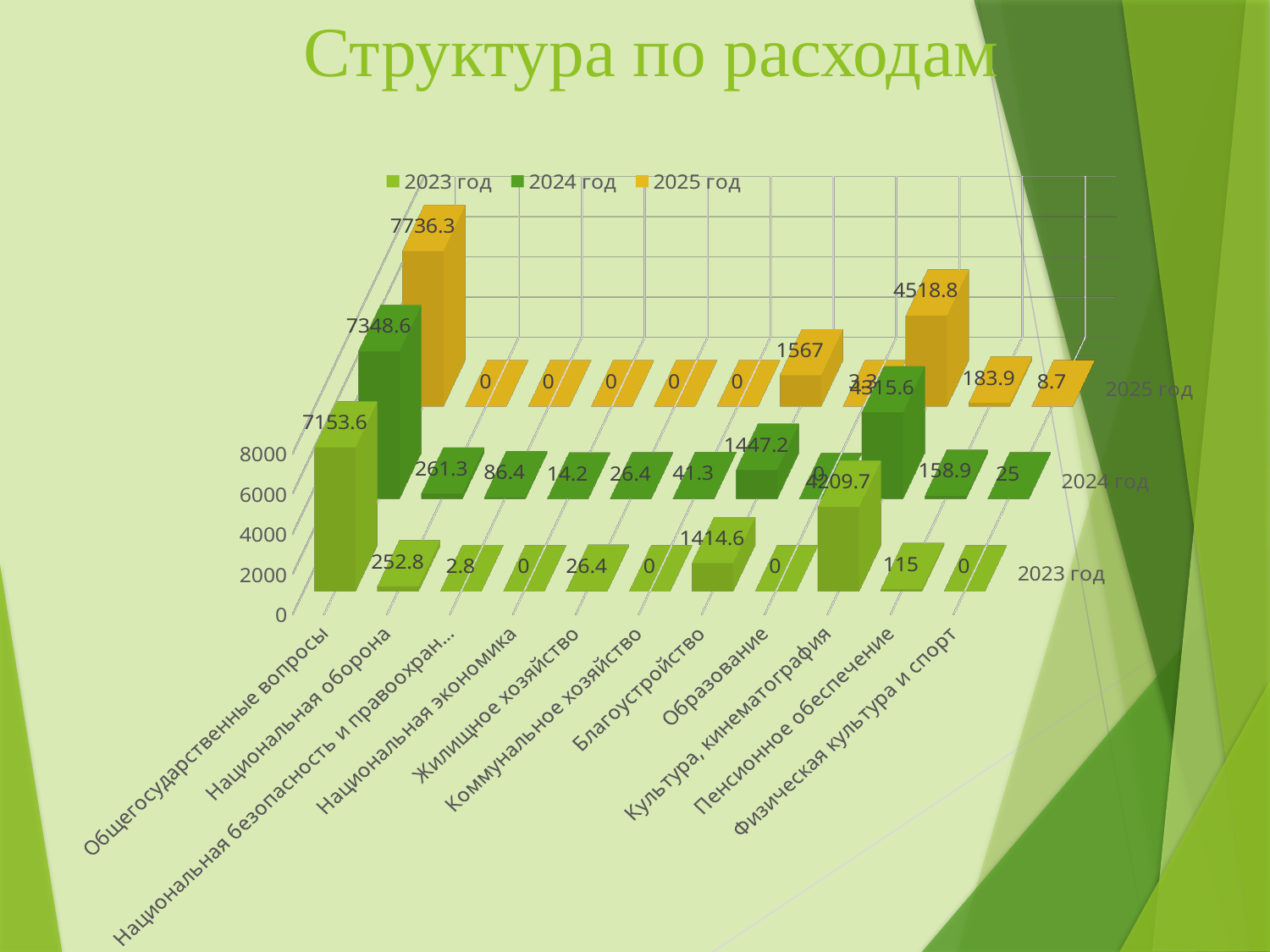
How many categories are shown on the x axis? 11 Does the value for Культура, кинематография rise or fall from 2023 год to 2025 год? Rise What kind of chart is shown on the slide? Bar chart What is the title of the chart? Структура по расходам What is the value for Культура, кинематография in the 2023 год series? 4209.7 What is the value for Общегосударственные вопросы in the 2025 год series? 7736.3 Which is larger: the 2024 год value for Национальная оборона or the 2024 год value for Пенсионное обеспечение? Национальная оборона Which category has the highest value in the 2023 год series? Общегосударственные вопросы What is the value for Пенсионное обеспечение in the 2024 год series? 158.9 How many series does the legend list? 3 What is the value for Благоустройство in the 2025 год series? 1567 What is the difference between the 2025 год and 2023 год values for Общегосударственные вопросы? 582.7